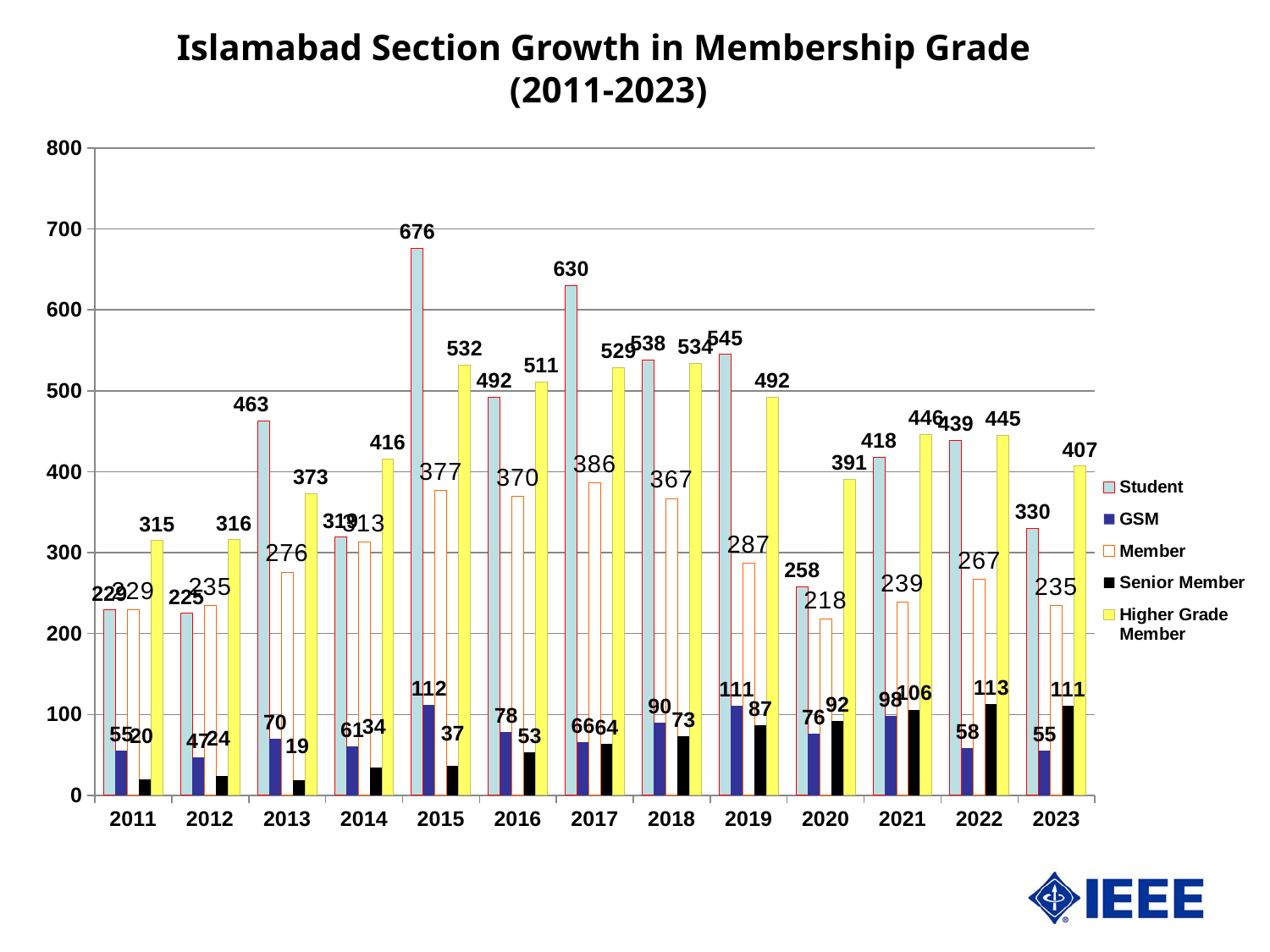
In which year is the Senior Member value lowest? 2013 Is the Student value for 2013 greater or less than 400? greater What is the Higher Grade Member value for 2023? 407 What is the Member value for 2020? 218 In 2015, which is larger: the Student value or the Higher Grade Member value? Student In which year is the Student value highest? 2015 How many years are shown on the x axis? 13 How many series does the legend list? 5 What is the difference between the Student values for 2015 and 2017? 46 What is the Student value for 2015? 676 What kind of chart is shown on the slide? Bar chart What is the Senior Member value for 2022? 113